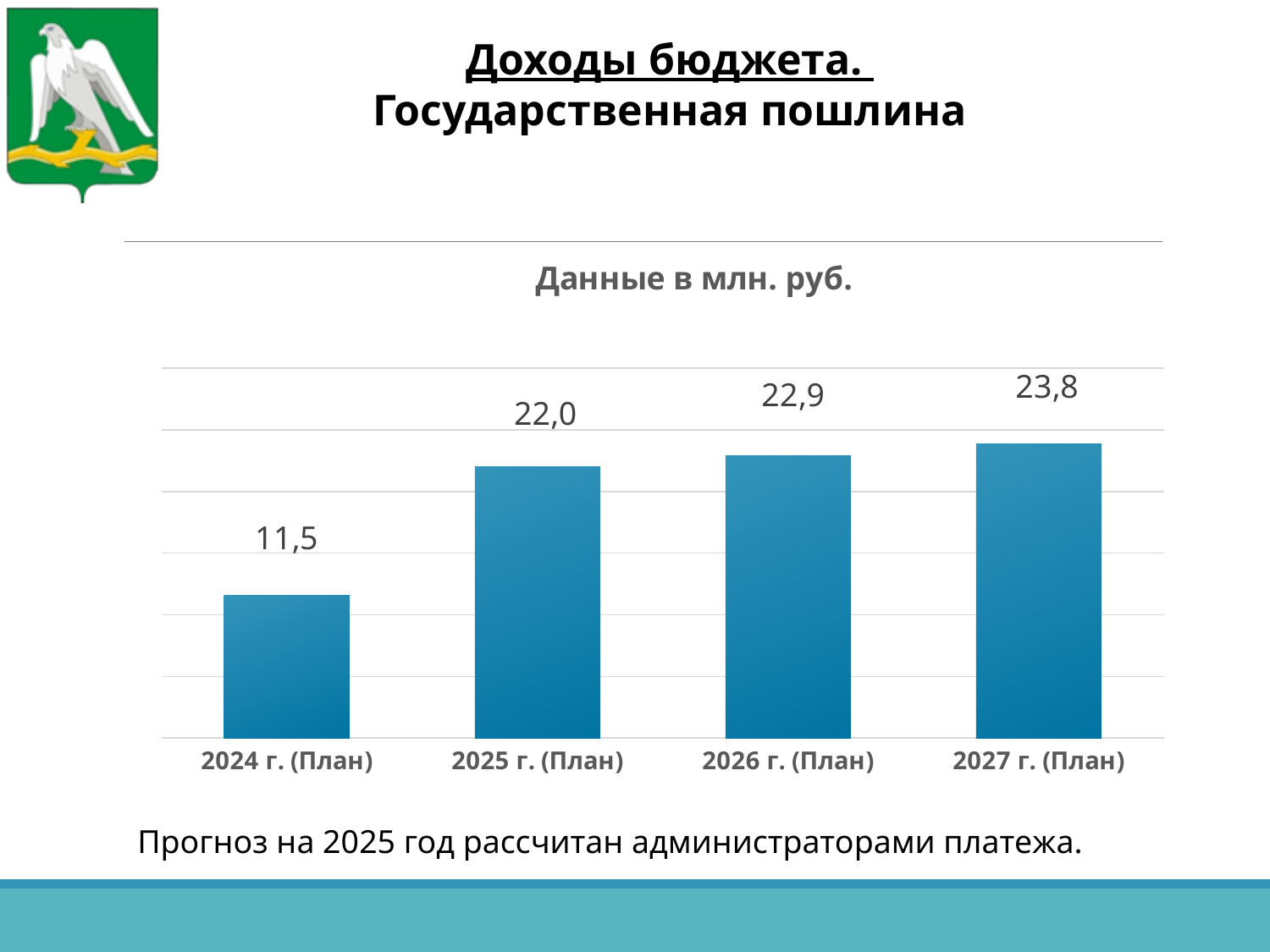
What is the value for 2027 г. (План)? 23,8 Which is larger, the value for 2026 г. (План) or the value for 2024 г. (План)? 2026 г. (План) What is the value for 2025 г. (План)? 22,0 Which category has the highest value? 2027 г. (План) What is the value for 2026 г. (План)? 22,9 Do the values rise or fall from 2024 г. (План) to 2027 г. (План)? rise What is the difference between the values for 2025 г. (План) and 2024 г. (План)? 10,5 How many categories are shown on the x axis? 4 What kind of chart is shown on the slide? bar chart Which category has the lowest value? 2024 г. (План) What is the difference between the values for 2027 г. (План) and 2026 г. (План)? 0,9 What is the value for 2024 г. (План)? 11,5